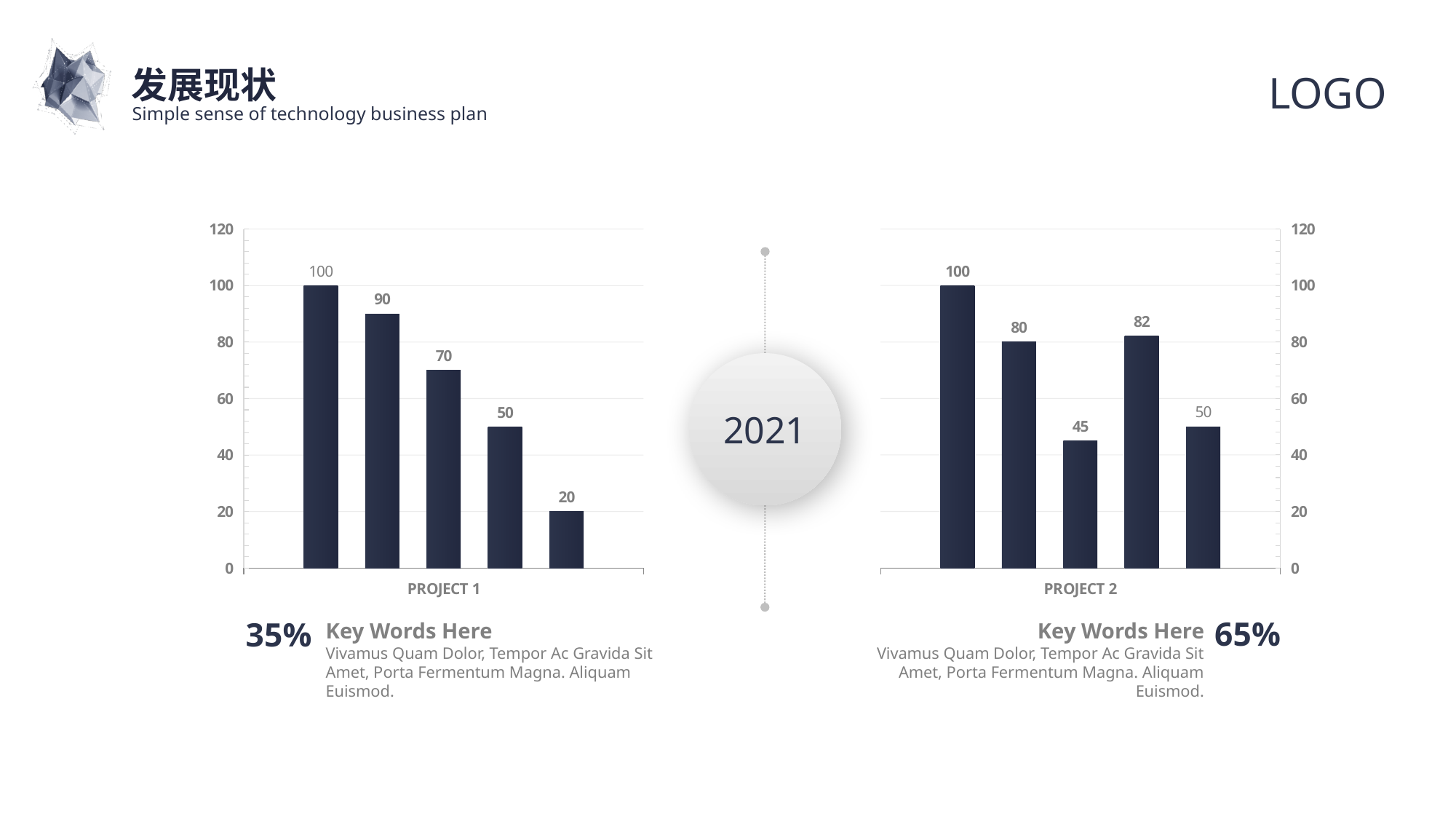
In the left chart (PROJECT 1), what is the value of the third bar from the left? 70 In the right chart (PROJECT 2), which is larger: the second bar or the fourth bar? the fourth bar (82) In the right chart (PROJECT 2), what is the value of the third bar from the left? 45 In the right chart (PROJECT 2), how many bars are plotted? 5 In the left chart (PROJECT 1), what is the difference between the first bar (100) and the last bar (20)? 80 In the left chart (PROJECT 1), what is the value of the shortest bar? 20 In the left chart (PROJECT 1), how many bars are plotted? 5 In the left chart (PROJECT 1), what is the value of the tallest bar? 100 What type of chart is the left chart labelled PROJECT 1? bar chart What year is shown in the circle between the two charts? 2021 In the right chart (PROJECT 2), what is the value of the fourth bar from the left? 82 In the left chart (PROJECT 1), do the bar values rise or fall from left to right? fall